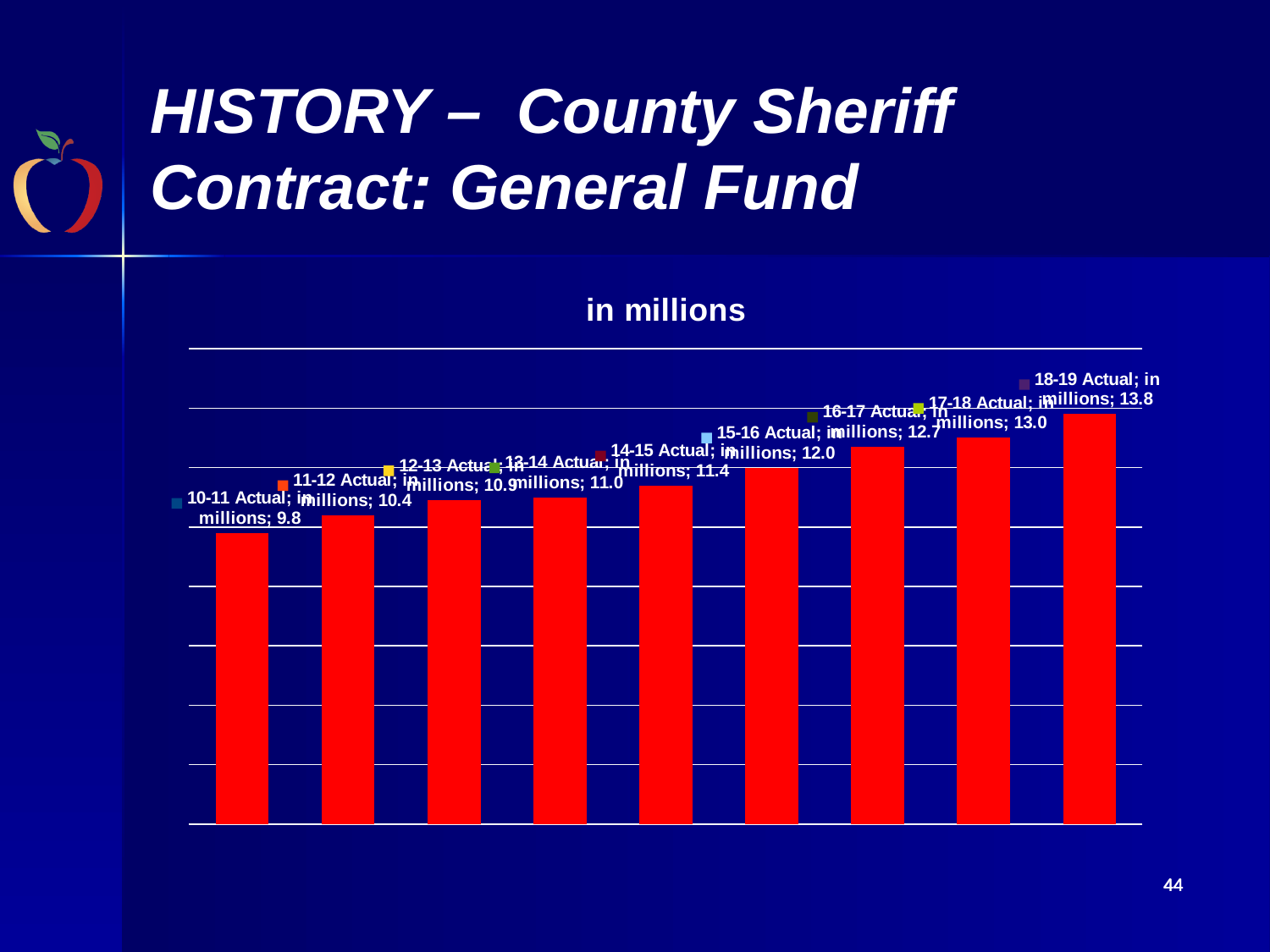
What is the difference between the 18-19 Actual and 10-11 Actual values? 4.0 What is the chart's title? in millions What is the value for 10-11 Actual? 9.8 What is the value for 18-19 Actual? 13.8 How many bars are plotted in the chart? 9 What kind of chart is shown on the slide? bar chart Do the values rise or fall from 10-11 Actual to 18-19 Actual? rise Which year has the highest value? 18-19 Actual Which year has the lowest value? 10-11 Actual What is the value for 14-15 Actual? 11.4 Which is larger, the value for 12-13 Actual or 17-18 Actual? 17-18 Actual What is the difference between the 16-17 Actual and 15-16 Actual values? 0.7